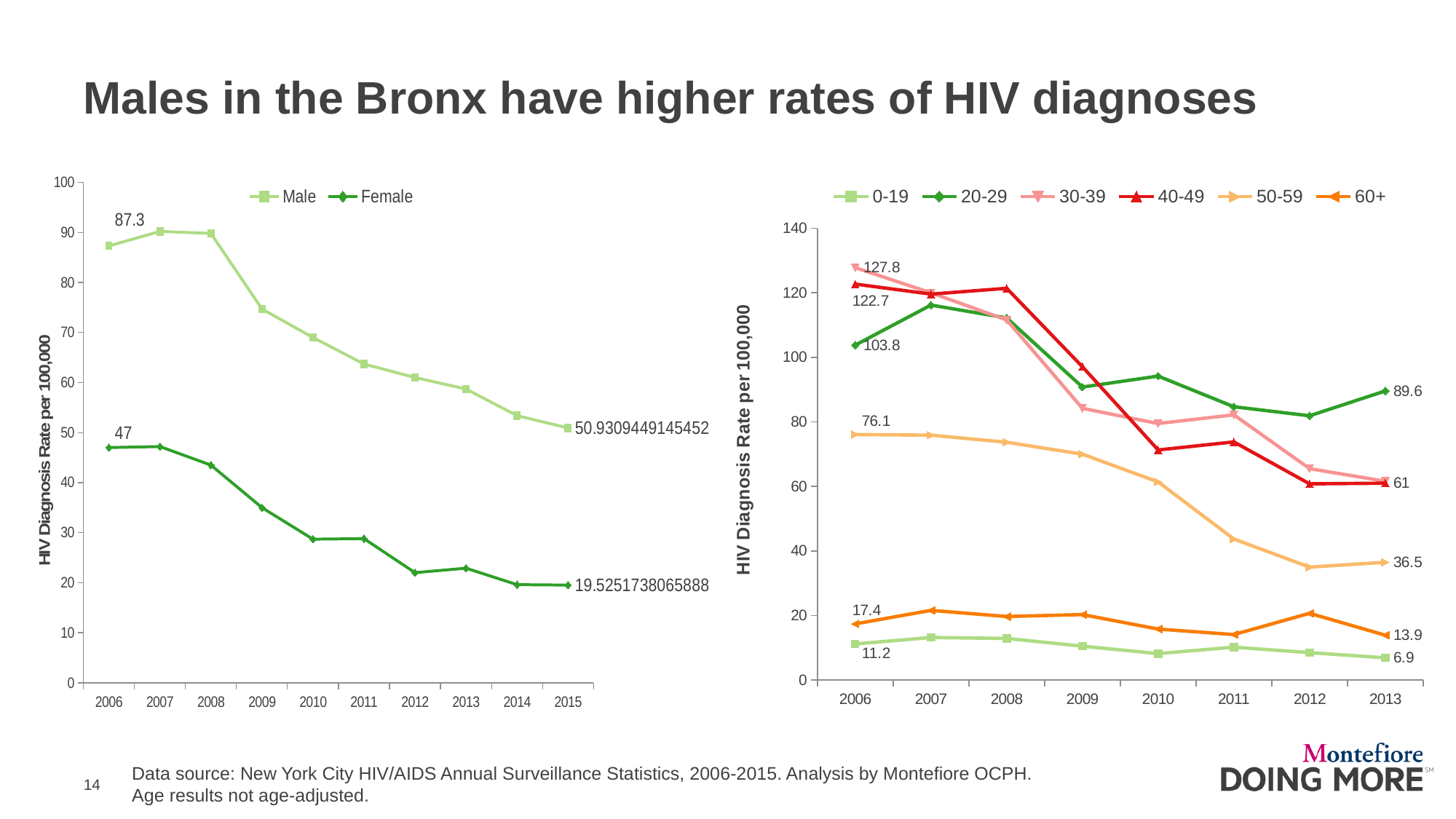
In the chart on the right, what is the HIV diagnosis rate for the 30-39 age group in 2006? 127.8 In the chart on the left, what is the HIV diagnosis rate for Female in 2006? 47 In the chart on the left, how many series does the legend list? 2 In the chart on the left, what is the HIV diagnosis rate for Male in 2006? 87.3 What kind of chart is the chart on the left of the slide? line chart In the chart on the left, is the Male value for 2010 greater or less than 60? greater In the chart on the left, does the Male rate rise or fall from 2006 to 2015? fall In the chart on the left, how many years are shown on the x axis? 10 In the chart on the right, how many age groups does the legend list? 6 In the chart on the right, what is the HIV diagnosis rate for the 50-59 age group in 2013? 36.5 In the chart on the left, what is the difference between the Male and Female rates in 2006? 40.3 In the chart on the right, which age group has the lowest rate in 2006? 0-19